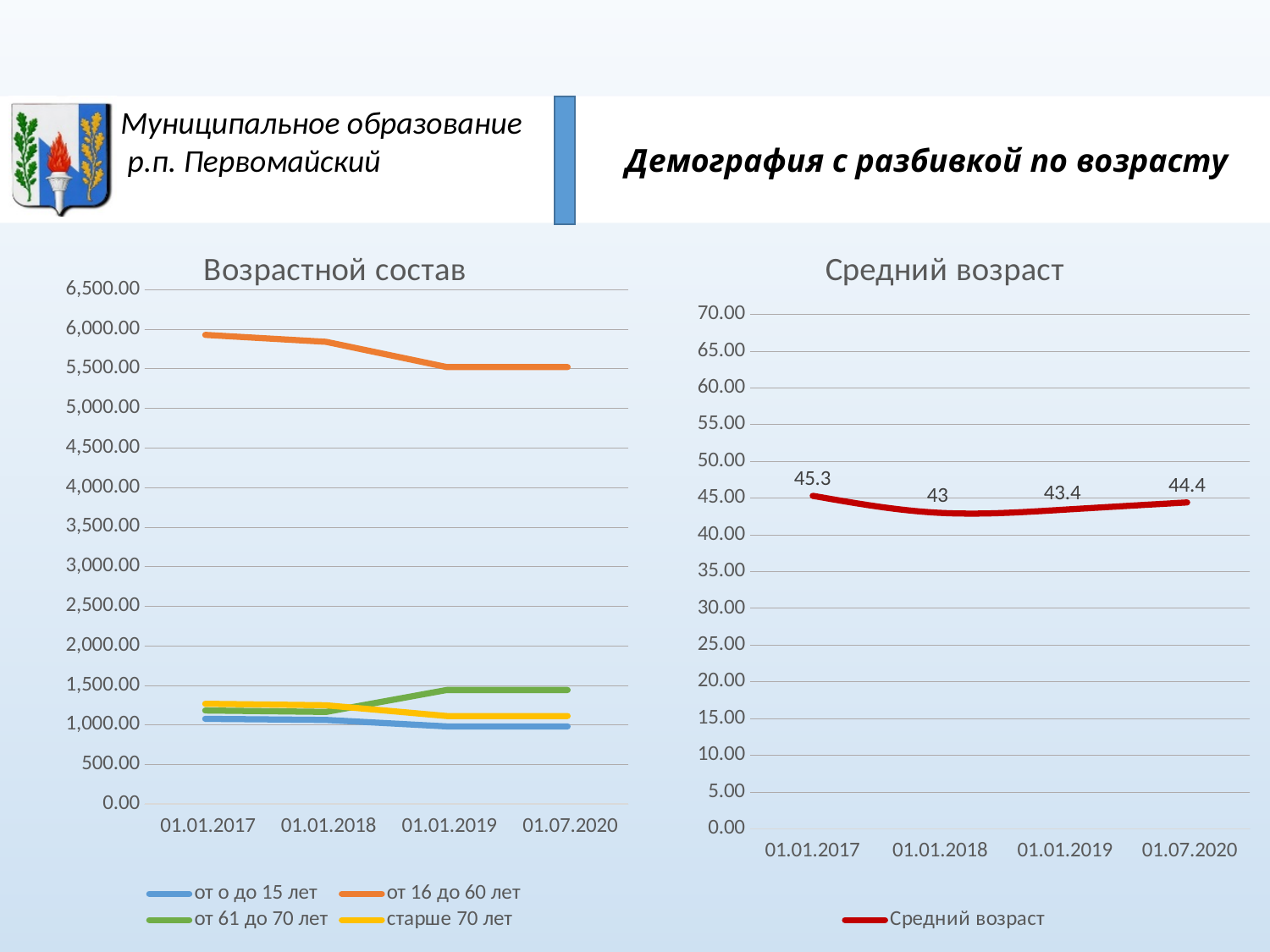
In the 'Средний возраст' chart, what is the value for 01.01.2017? 45.3 How many series does the legend of the 'Возрастной состав' chart list? 4 In the 'Средний возраст' chart, what is the value for 01.01.2018? 43 In the 'Возрастной состав' chart, is the value for 'от 16 до 60 лет' at 01.01.2017 greater or less than 5,500.00? greater In the 'Средний возраст' chart, which date has the lowest value? 01.01.2018 In the 'Средний возраст' chart, which date has the highest value? 01.01.2017 How many dates are shown on the x axis of the 'Средний возраст' chart? 4 In the 'Средний возраст' chart, what is the value for 01.07.2020? 44.4 In the 'Средний возраст' chart, what is the difference between the values for 01.01.2017 and 01.01.2018? 2.3 In the 'Средний возраст' chart, which is larger: the value for 01.01.2019 or 01.07.2020? 01.07.2020 In the 'Возрастной состав' chart, does the 'от 16 до 60 лет' series rise or fall from 01.01.2017 to 01.01.2019? fall What kind of chart is 'Возрастной состав'? line chart